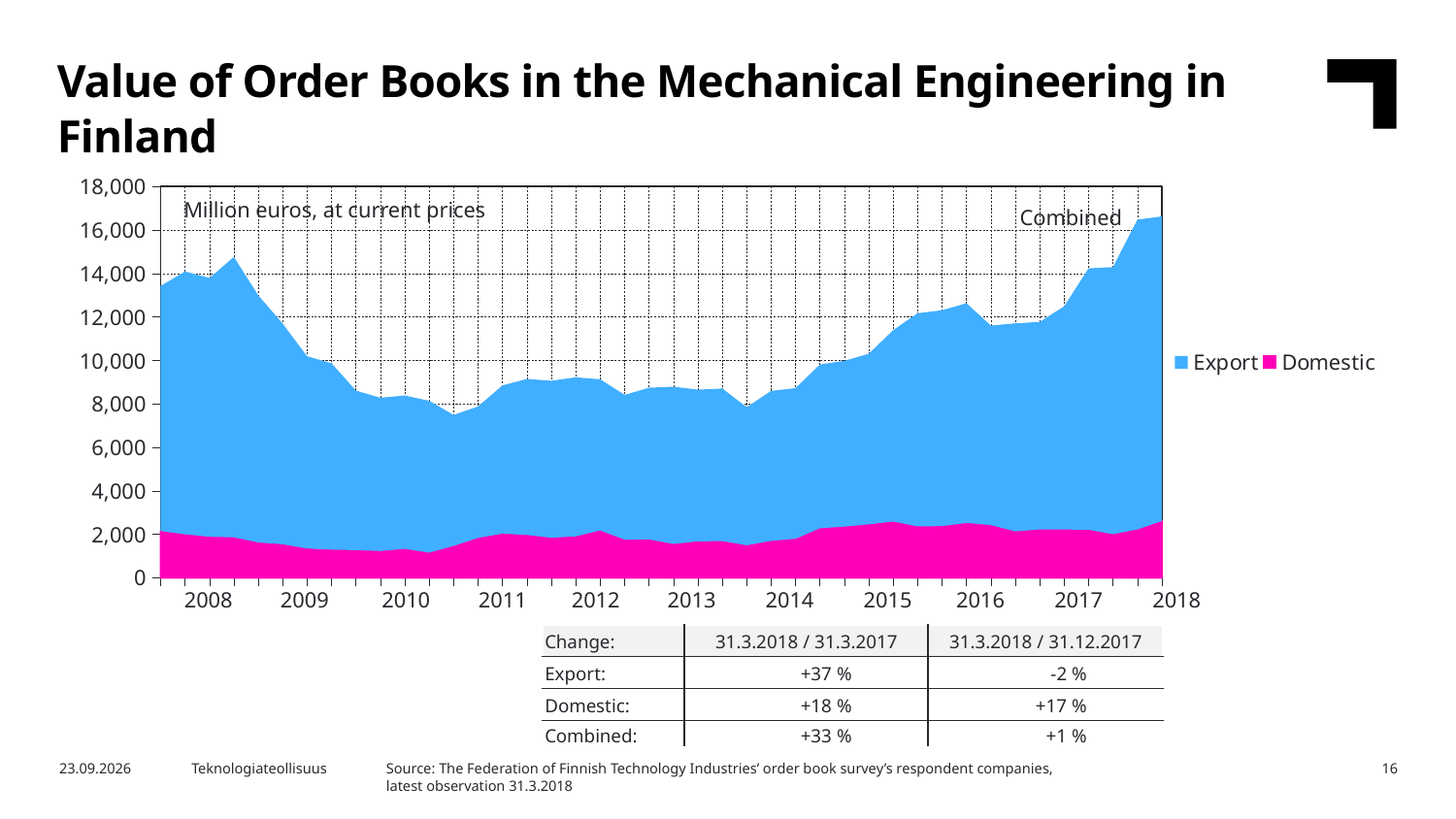
Is the combined value at the start of 2016 greater or less than 12,000? greater Is the combined value at the start of 2013 greater or less than 10,000? less Is the combined value at the start of 2018 greater or less than 16,000? greater In which year does the combined value reach its highest level? 2018 Does the combined value rise or fall between 2016 and 2018? rise How many year labels are shown on the x axis? 11 What type of chart is shown on the slide? Stacked area chart How many series does the legend list? 2 What unit is stated in the chart's annotation? Million euros, at current prices Which two series are listed in the chart legend? Export and Domestic